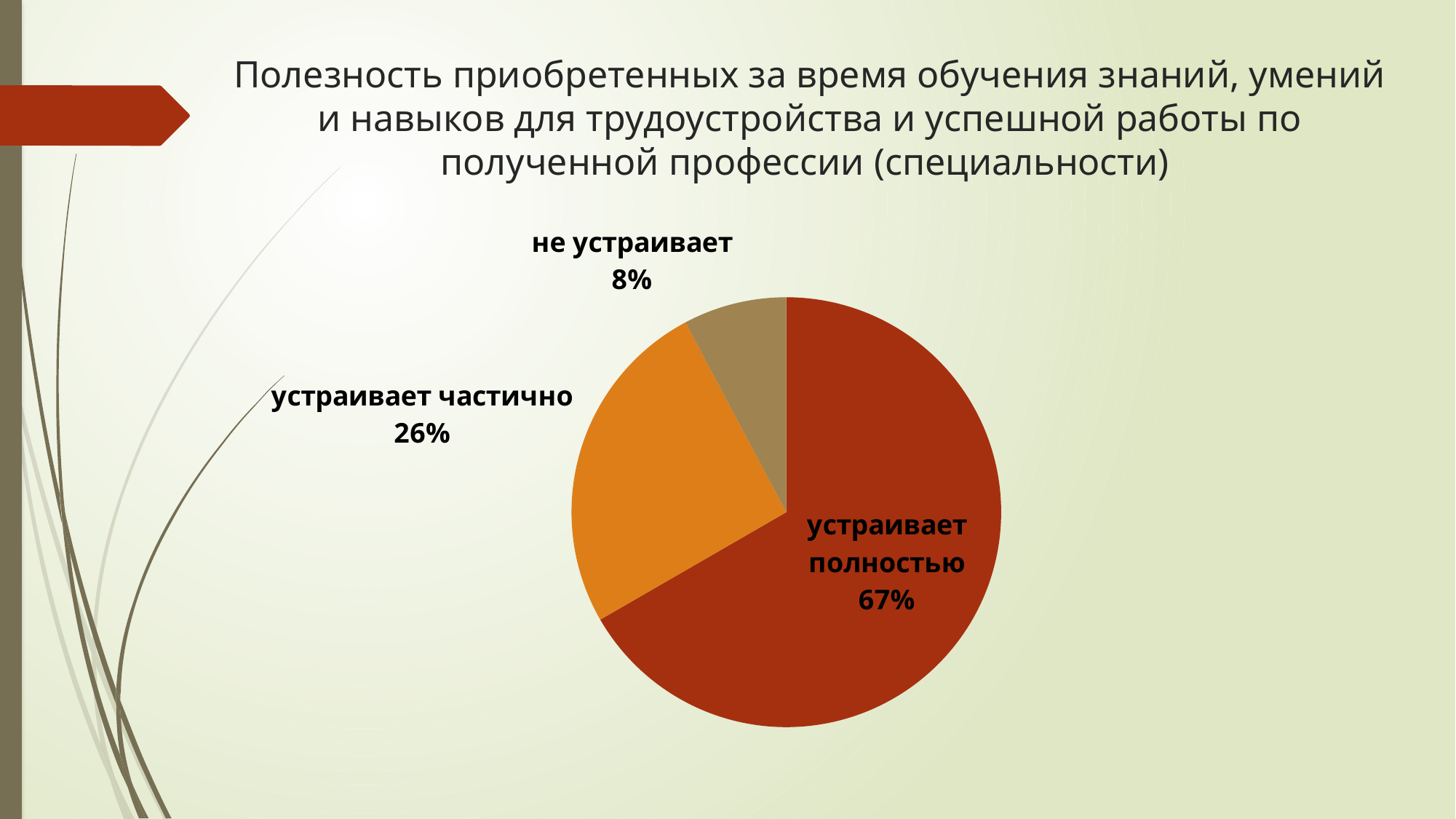
What colour is the slice for "устраивает частично"? orange How many slices does the pie chart have? 3 Which category has the smallest slice of the pie? не устраивает What type of chart is shown on the slide? pie chart What share of the pie does "устраивает частично" have? 26% What share of the pie does "не устраивает" have? 8% Which is larger: the slice for "устраивает частично" or the slice for "не устраивает"? устраивает частично What colour is the slice for "устраивает полностью"? dark red Which category has the largest slice of the pie? устраивает полностью What share of the pie does "устраивает полностью" have? 67% What is the difference in percentage points between "устраивает частично" and "не устраивает"? 18 What is the difference in percentage points between "устраивает полностью" and "устраивает частично"? 41